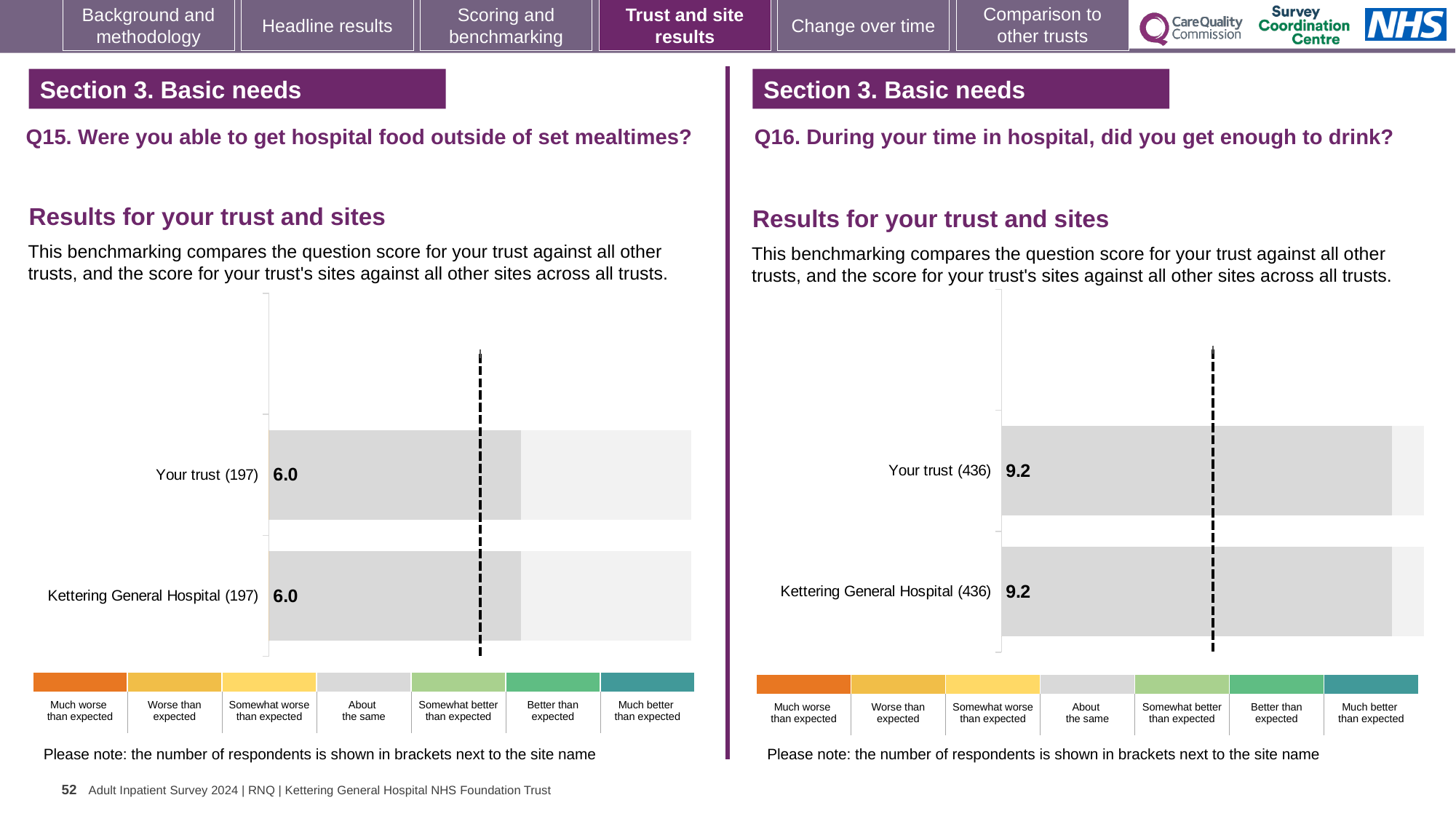
Which is larger: the Your trust score on the Q16 chart (right) or the Your trust score on the Q15 chart (left)? Q16 (9.2) On the Q15 chart (left), how many respondents are shown in brackets next to Your trust? 197 On the Q16 chart (right), is the score for Your trust larger, smaller, or the same as the score for Kettering General Hospital? The same On the Q15 chart (left), what is the difference between the score for Your trust and the score for Kettering General Hospital? 0.0 On the Q15 chart (left), what is the score for Your trust? 6.0 On the Q15 chart (left), what is the score for Kettering General Hospital? 6.0 How many colour categories does the legend below the Q16 chart (right) list? 7 On the Q15 chart (left), how many bars are plotted? 2 On the Q16 chart (right), how many bars are plotted? 2 What kind of chart is used on the Q16 chart (right)? Bar chart On the Q16 chart (right), what is the score for Your trust? 9.2 On the Q16 chart (right), what is the score for Kettering General Hospital? 9.2